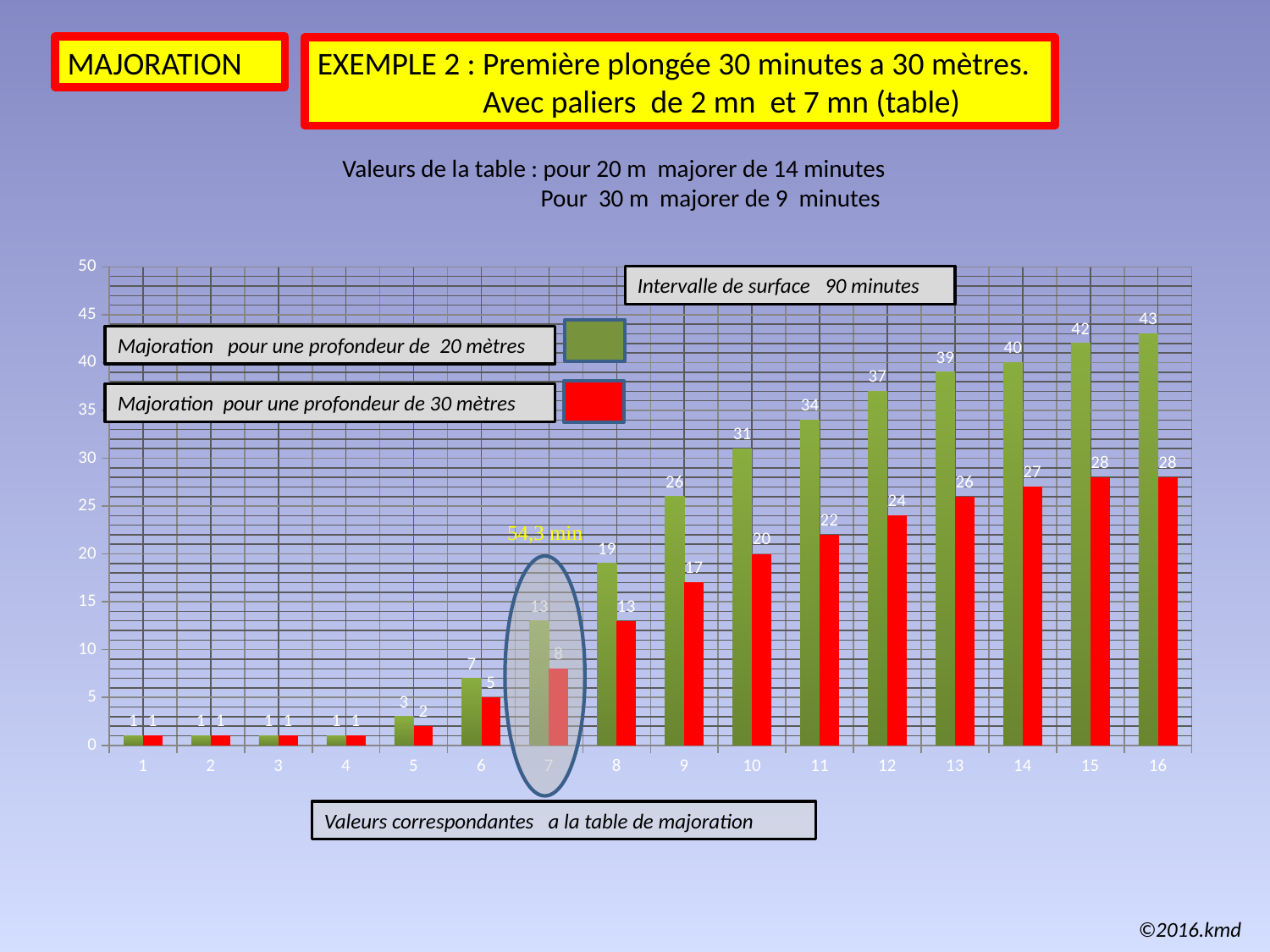
What surface interval is stated in the box on the chart? 90 minutes How many series does the chart's legend list? 2 What kind of chart is shown on the slide? bar chart What is the difference between the green and red values at category 13? 13 How many categories are shown along the x axis of the chart? 16 At category 10, which series has the larger value, the green (20 mètres) or the red (30 mètres)? green (20 mètres) What is the value of the red series (Majoration pour une profondeur de 30 mètres) at category 12? 24 What is the value of the green series (Majoration pour une profondeur de 20 mètres) at category 9? 26 Do the values of the red series rise or fall as the category number increases from 1 to 16? rise Which colour represents the series 'Majoration pour une profondeur de 30 mètres'? red Which category has the highest value for the green series (20 mètres)? 16 What is the value of the green series at category 7, the highlighted category? 13